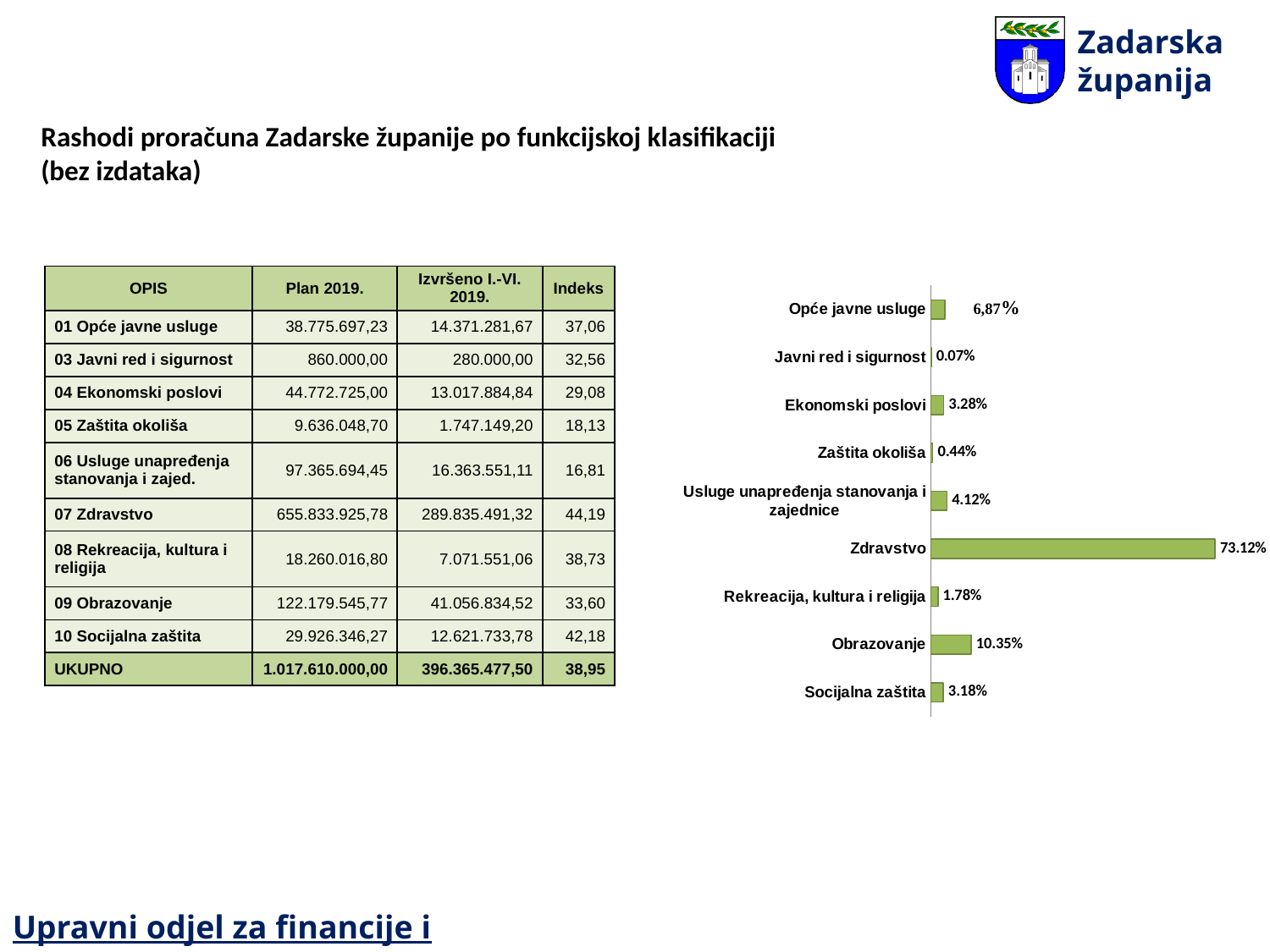
In the bar chart, what is the value for Obrazovanje? 10.35% In the bar chart, what is the value for Javni red i sigurnost? 0.07% In the bar chart, which is larger: the value for Obrazovanje or the value for Usluge unapređenja stanovanja i zajednice? Obrazovanje In the bar chart, what is the difference between the values for Zdravstvo and Obrazovanje? 62.77% How many categories does the bar chart show? 9 In the bar chart, what is the value for Zdravstvo? 73.12% What kind of chart is shown on the right side of the slide? bar chart Which category has the lowest value in the bar chart? Javni red i sigurnost In the bar chart, what is the value for Opće javne usluge? 6,87% In the bar chart, what is the value for Usluge unapređenja stanovanja i zajednice? 4.12% In the bar chart, what is the difference between the values for Obrazovanje and Socijalna zaštita? 7.17% Which category has the highest value in the bar chart? Zdravstvo